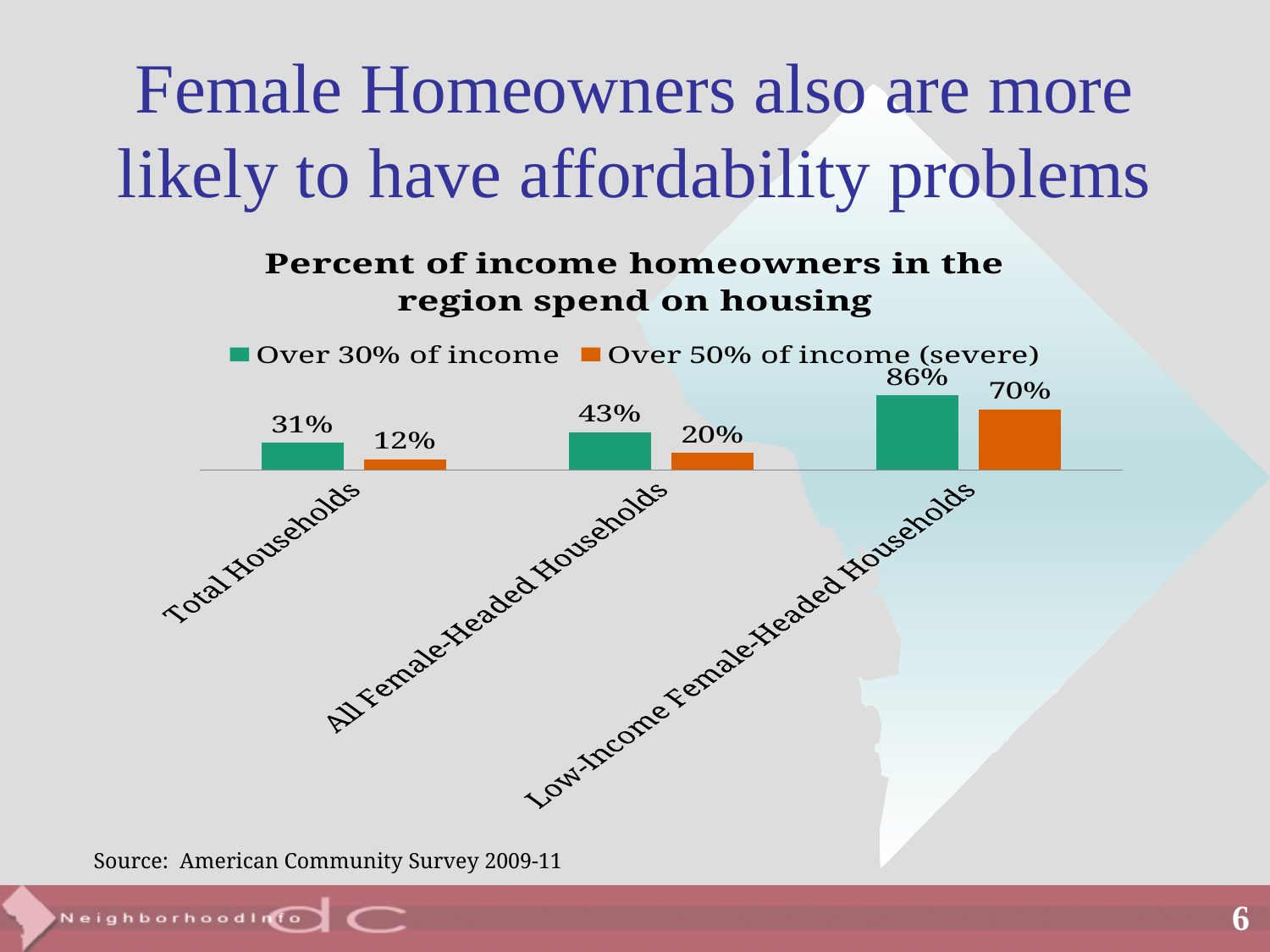
How many series does the legend list? 2 What percent of All Female-Headed Households spend over 50% of income (severe) on housing? 20% Which is larger: the 'Over 50% of income (severe)' value for All Female-Headed Households or for Total Households? All Female-Headed Households Which category has the highest value for 'Over 30% of income'? Low-Income Female-Headed Households How many categories are shown on the x axis? 3 What is the value for Low-Income Female-Headed Households in the 'Over 30% of income' series? 86% What is the difference between the 'Over 30% of income' and 'Over 50% of income (severe)' values for All Female-Headed Households? 23% What is the value for Low-Income Female-Headed Households in the 'Over 50% of income (severe)' series? 70% Which category has the lowest value for 'Over 50% of income (severe)'? Total Households What is the difference between the 'Over 30% of income' values for Low-Income Female-Headed Households and Total Households? 55% What kind of chart is shown on the slide? Bar chart What percent of Total Households spend over 30% of income on housing? 31%